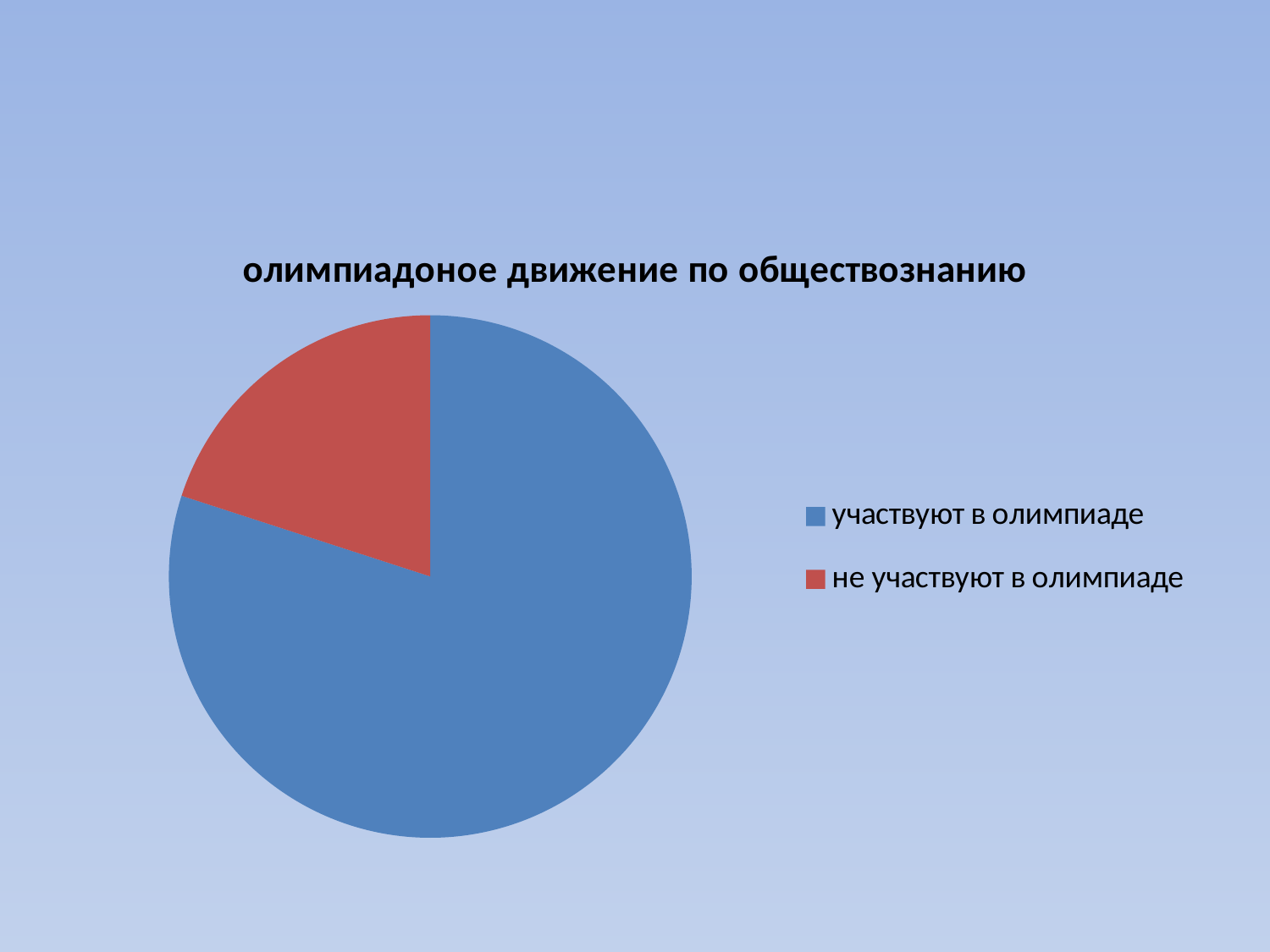
What is the title of the chart? олимпиадоное движение по обществознанию How many entries does the legend list? 2 How many slices does the pie chart have? 2 What colour represents "не участвуют в олимпиаде" in the chart? red What kind of chart is shown on the slide? pie chart Which category has the largest slice of the pie? участвуют в олимпиаде Which category has the smallest slice of the pie? не участвуют в олимпиаде Which slice is larger: "участвуют в олимпиаде" or "не участвуют в олимпиаде"? участвуют в олимпиаде